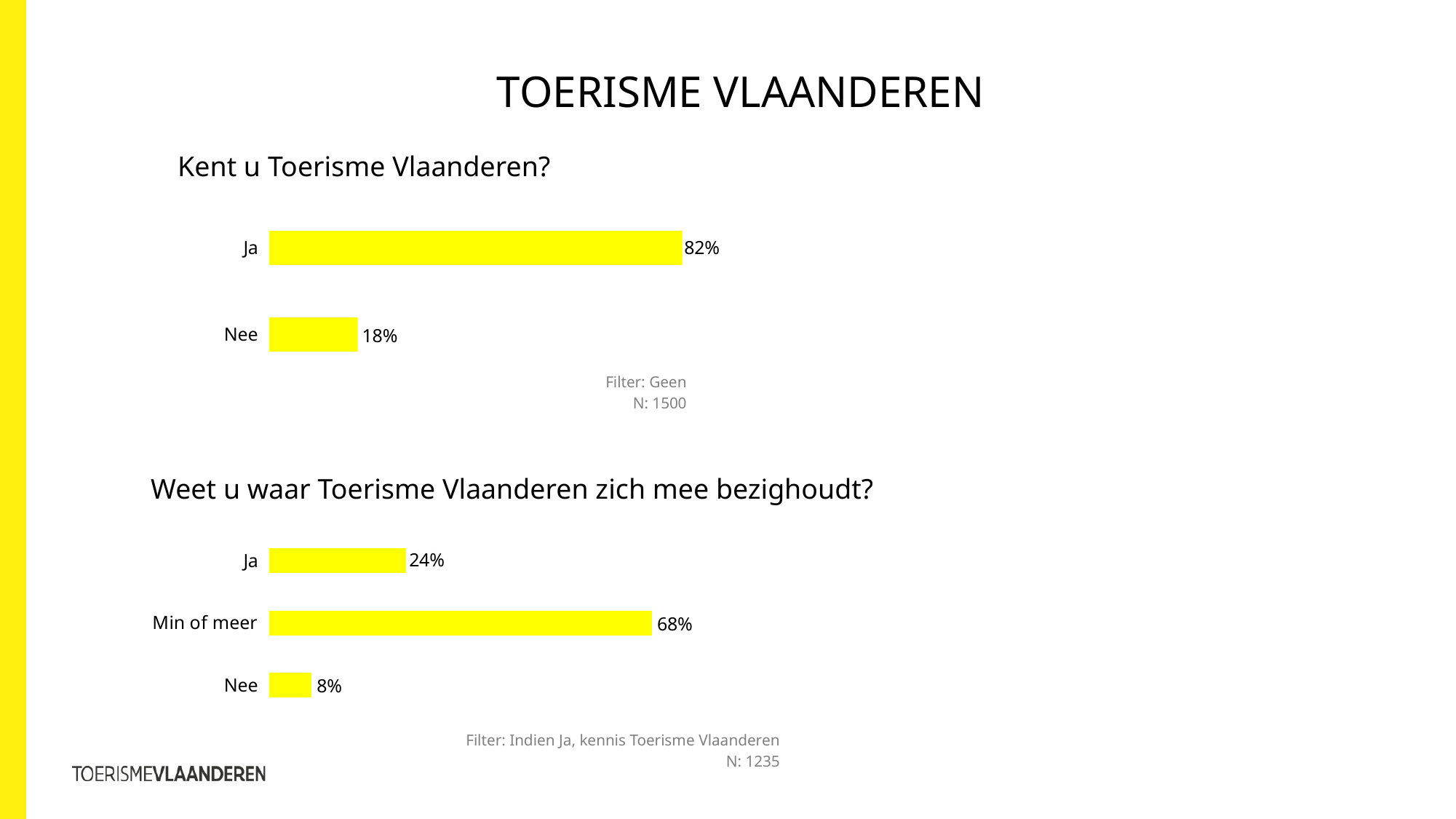
In the chart 'Weet u waar Toerisme Vlaanderen zich mee bezighoudt?', what is the value for Ja? 24% In the chart 'Weet u waar Toerisme Vlaanderen zich mee bezighoudt?', how many categories are shown? 3 In the chart 'Weet u waar Toerisme Vlaanderen zich mee bezighoudt?', which category has the lowest value? Nee In the chart 'Kent u Toerisme Vlaanderen?', what is the difference between Ja and Nee? 64% In the chart 'Kent u Toerisme Vlaanderen?', what is the value for Nee? 18% In the chart 'Kent u Toerisme Vlaanderen?', what is the value for Ja? 82% In the chart 'Kent u Toerisme Vlaanderen?', how many categories are shown? 2 In the chart 'Weet u waar Toerisme Vlaanderen zich mee bezighoudt?', what is the difference between Min of meer and Ja? 44% In the chart 'Weet u waar Toerisme Vlaanderen zich mee bezighoudt?', which category has the highest value? Min of meer In the chart 'Weet u waar Toerisme Vlaanderen zich mee bezighoudt?', what is the value for Min of meer? 68% In the chart 'Weet u waar Toerisme Vlaanderen zich mee bezighoudt?', what is the value for Nee? 8% What type of chart is the top chart 'Kent u Toerisme Vlaanderen?'? Bar chart